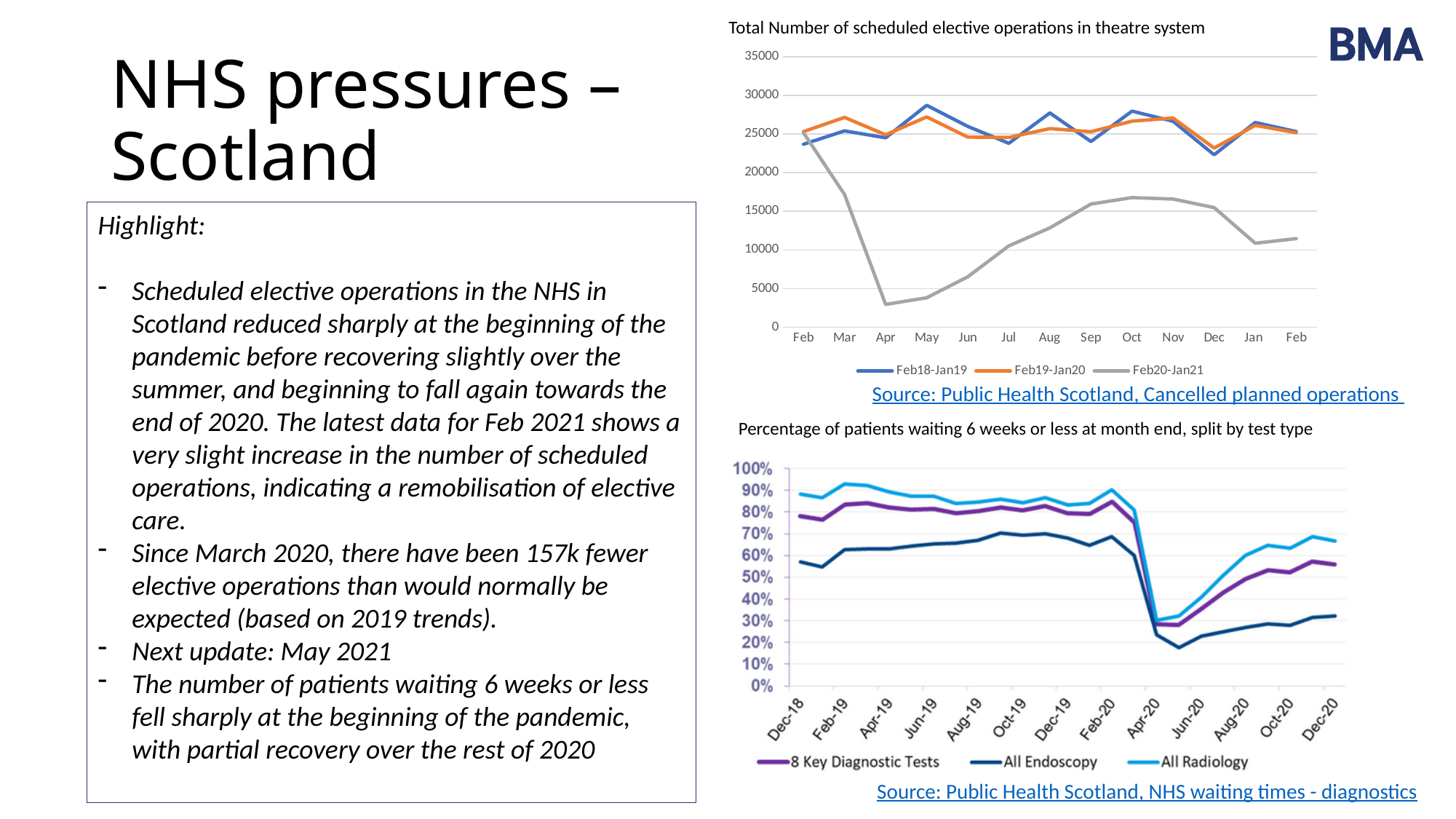
What type of chart is the top chart, 'Total Number of scheduled elective operations in theatre system'? line chart In the top chart (scheduled elective operations), is the Feb20-Jan21 value for Oct greater or less than 15000? greater In the top chart (scheduled elective operations), is the Feb20-Jan21 value for Apr greater or less than 5000? less In the top chart (scheduled elective operations), is the Feb18-Jan19 value for May greater or less than 25000? greater How many series does the legend of the bottom chart (percentage of patients waiting 6 weeks or less) list? 3 In the top chart (scheduled elective operations), which series has the larger value in Apr: Feb18-Jan19 or Feb20-Jan21? Feb18-Jan19 In the bottom chart (percentage of patients waiting 6 weeks or less), which series has the larger value in Dec-20: All Radiology or All Endoscopy? All Radiology In the top chart (scheduled elective operations), which month has the lowest value for the Feb20-Jan21 series? Apr In the top chart (scheduled elective operations), does the Feb20-Jan21 series rise or fall from Feb to Apr? fall How many series does the legend of the top chart (scheduled elective operations) list? 3